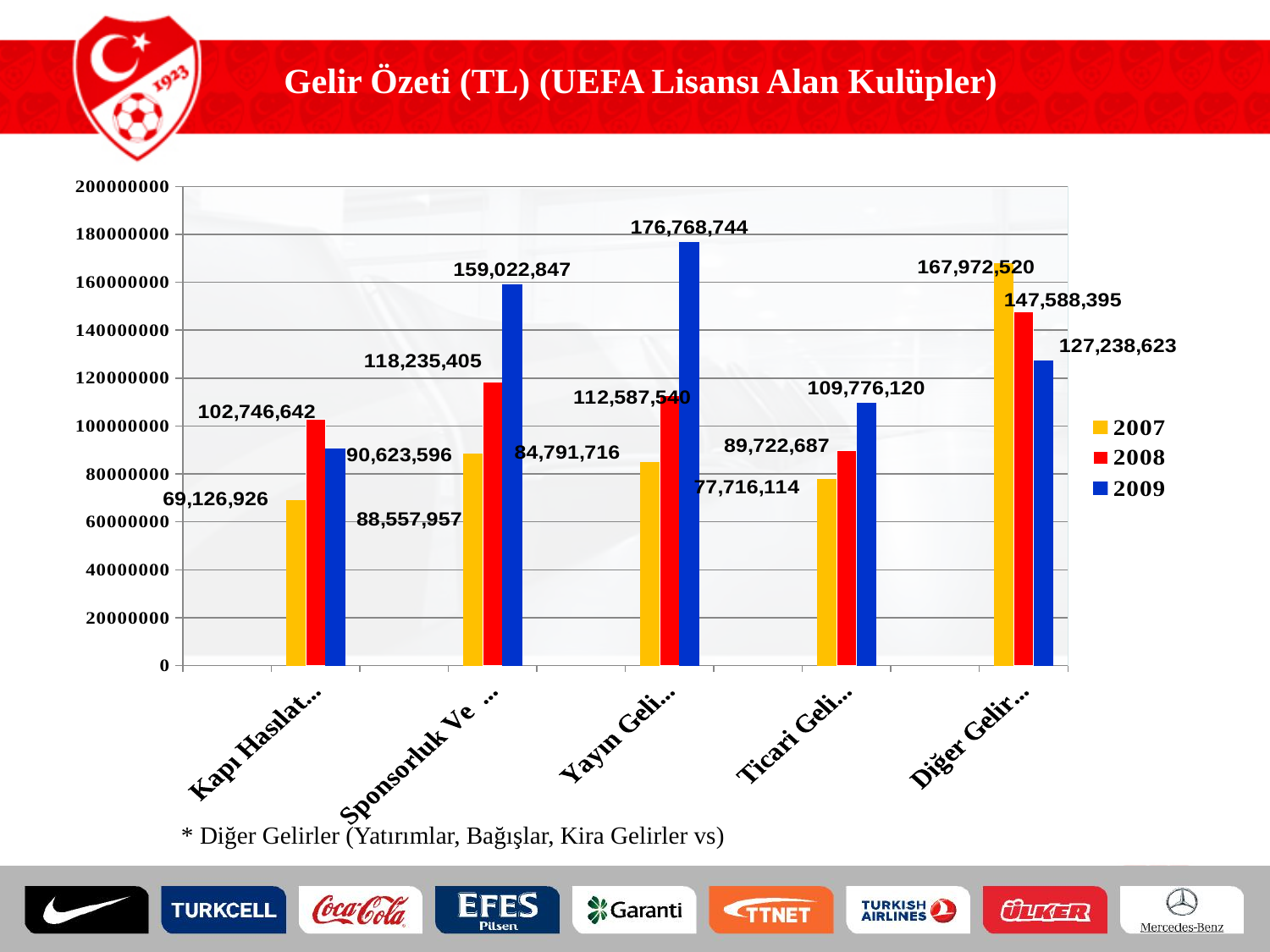
What is the difference between the 2009 and 2008 values for "Sponsorluk Ve ..."? 40,787,442 What are the legend entries of the chart? 2007, 2008, 2009 What is the 2009 value for the "Yayın Geli..." category? 176,768,744 How many categories are shown on the x axis? 5 What kind of chart is shown on the slide? bar chart Which category has the lowest 2007 value? Kapı Hasılat... How many series does the legend list? 3 Do the values for "Diğer Gelir..." rise or fall from 2007 to 2009? fall What is the 2007 value for the "Diğer Gelir..." category? 167,972,520 For "Kapı Hasılat...", which is larger: the 2008 value or the 2009 value? 2008 What is the 2008 value for the "Ticari Geli..." category? 89,722,687 Which category has the highest 2009 value? Yayın Geli...